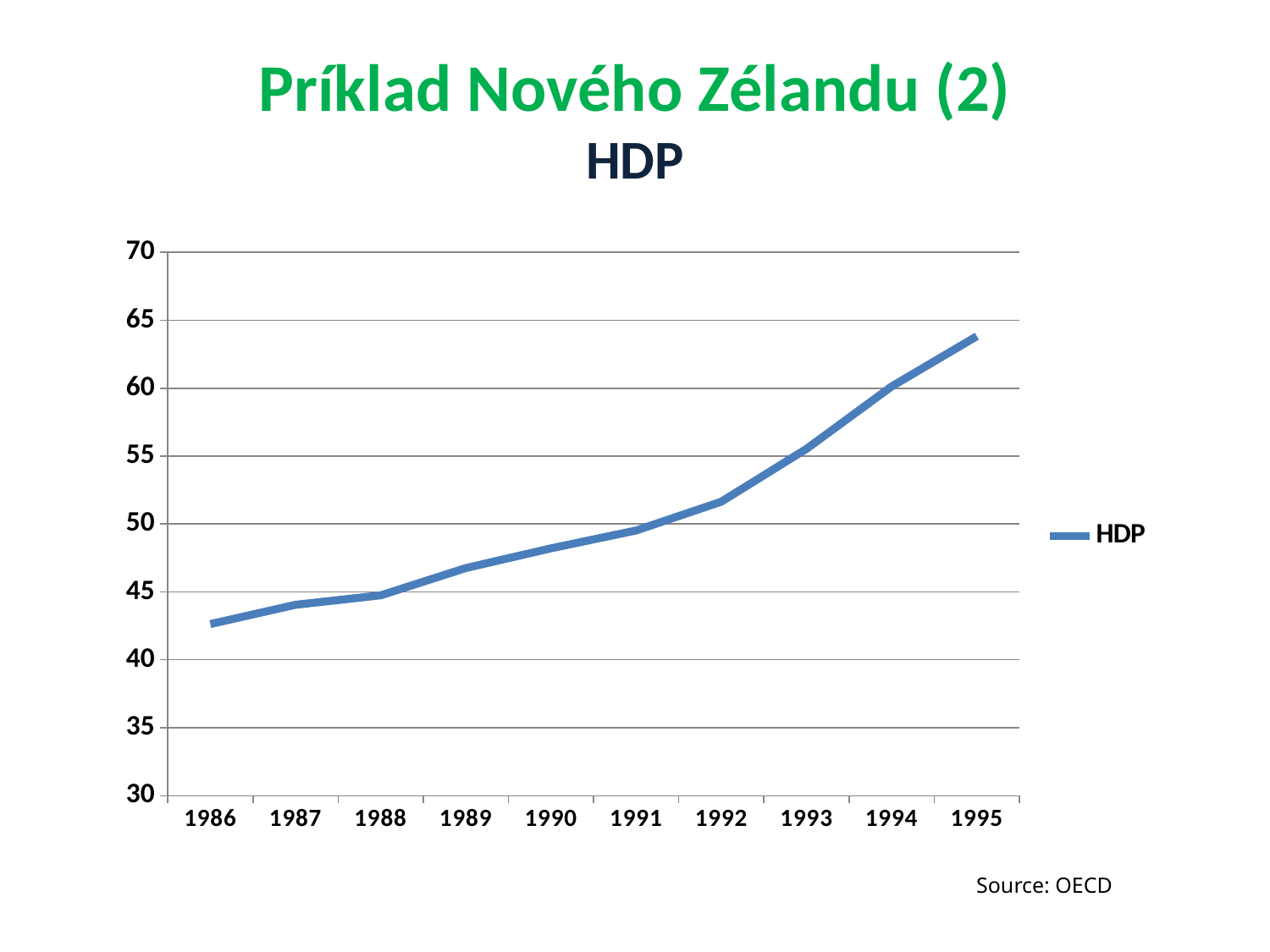
What kind of chart is shown on the slide? line chart Is the HDP value for 1992 greater or less than 50? greater Which year has the highest HDP value? 1995 Is the HDP value for 1995 greater or less than 60? greater How many series does the legend list? 1 Is the HDP value for 1986 greater or less than 45? less Which year has the lowest HDP value? 1986 Which year has a higher HDP value, 1988 or 1993? 1993 Does the HDP value rise or fall from 1986 to 1995? rise How many years are plotted on the x axis? 10